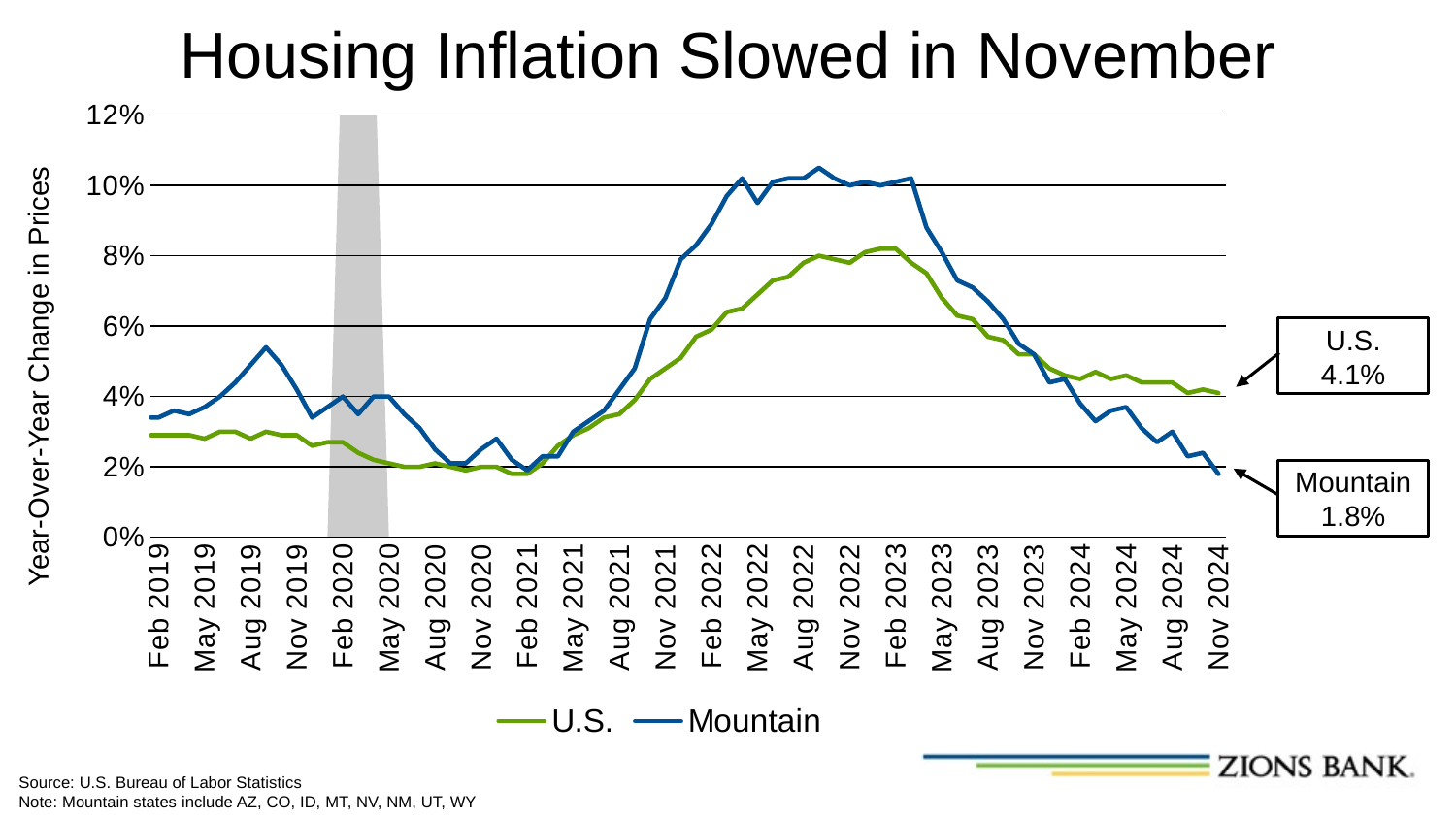
What is the Mountain year-over-year change in housing prices for November 2024? 1.8% Is the Mountain series' peak value in 2022 greater or less than 10%? greater What is the U.S. year-over-year change in housing prices for November 2024? 4.1% In November 2024, which series has the higher value, U.S. or Mountain? U.S. What kind of chart is shown on the slide? Line chart What is the label on the vertical axis? Year-Over-Year Change in Prices By how many percentage points does the U.S. value exceed the Mountain value in November 2024? 2.3 percentage points Is the U.S. value in February 2019 greater or less than 4%? less What is the title of the chart? Housing Inflation Slowed in November Does the Mountain series rise or fall from February 2023 to November 2024? fall How many series does the legend list? 2 Which series reaches the higher peak value over the period shown? Mountain